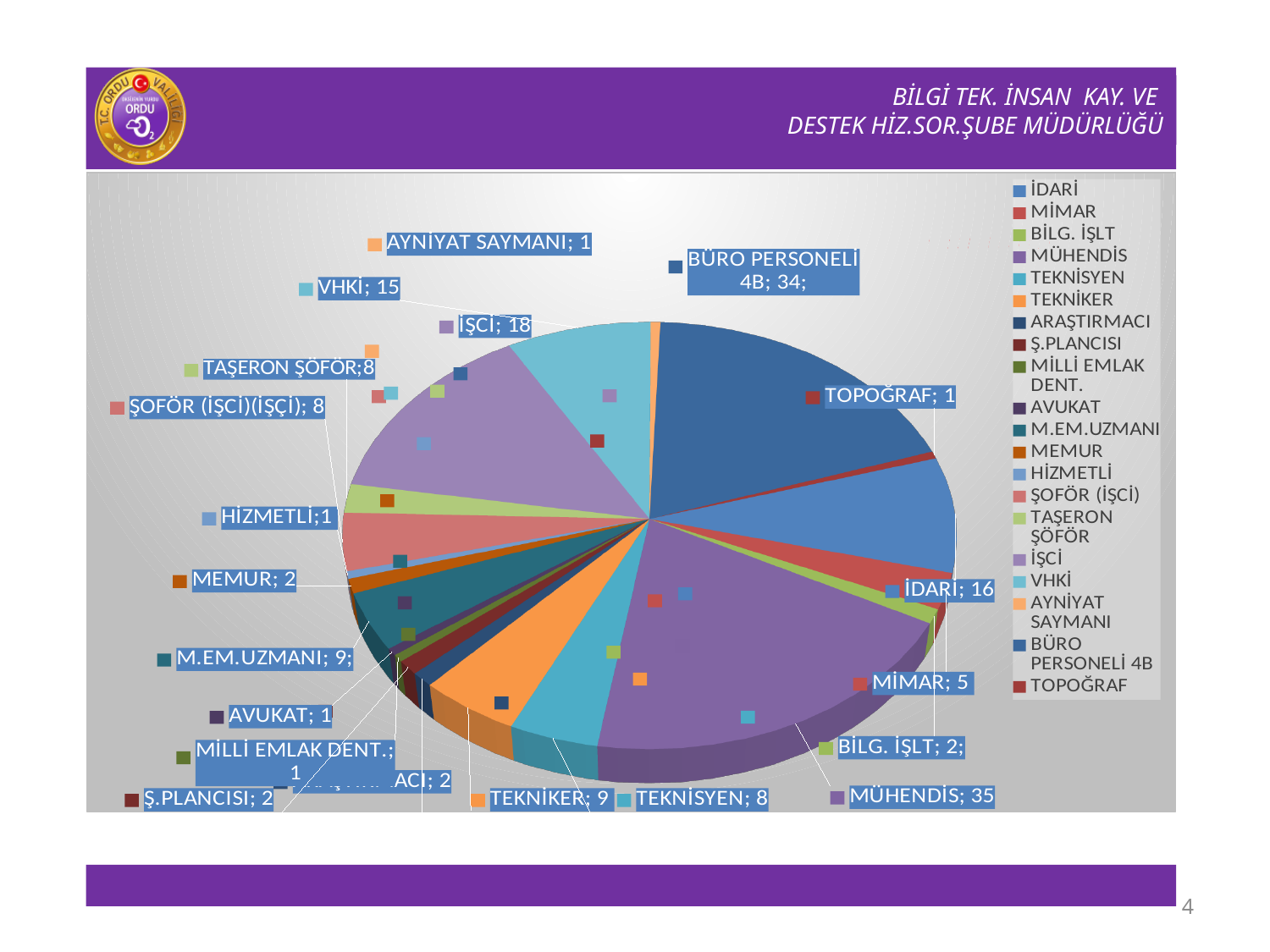
Which is larger, the value for M.EM.UZMANI or the value for MİMAR? M.EM.UZMANI How many categories does the legend list? 20 Which category has the highest value? MÜHENDİS What is the value for MÜHENDİS? 35 What is the value for İDARİ? 16 What is the value for TEKNİSYEN? 8 What kind of chart is shown on the slide? Pie chart What is the value for TEKNİKER? 9 What is the difference between the values for İŞÇİ and VHKİ? 3 What is the value for BÜRO PERSONELİ 4B? 34 What is the value for VHKİ? 15 What is the difference between the values for MÜHENDİS and İDARİ? 19